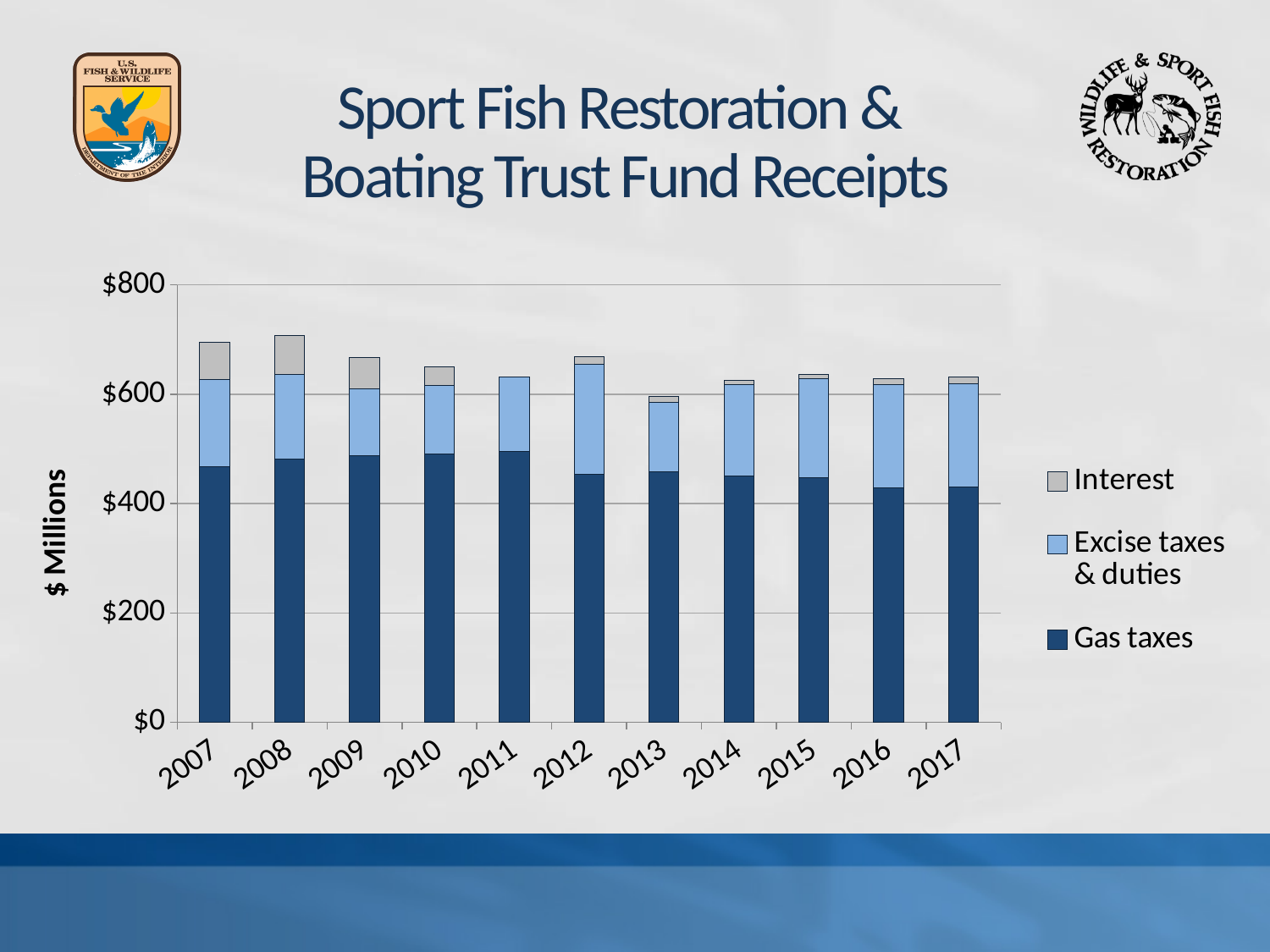
Which year has the lowest total receipts bar? 2013 Is the Gas taxes value for 2017 greater or less than $600? less How many series does the chart's legend list? 3 What is the title of the chart on the slide? Sport Fish Restoration & Boating Trust Fund Receipts Which year has the tallest total receipts bar? 2008 What is the label on the vertical axis of the chart? $ Millions Which year has the smallest Interest segment? 2011 How many years are shown along the x axis of the chart? 11 Which year's total receipts bar is taller, 2008 or 2013? 2008 Is the total receipts bar for 2008 greater or less than $600? greater What kind of chart is shown on the slide? Stacked bar chart Is the Gas taxes value for 2011 greater or less than $400? greater